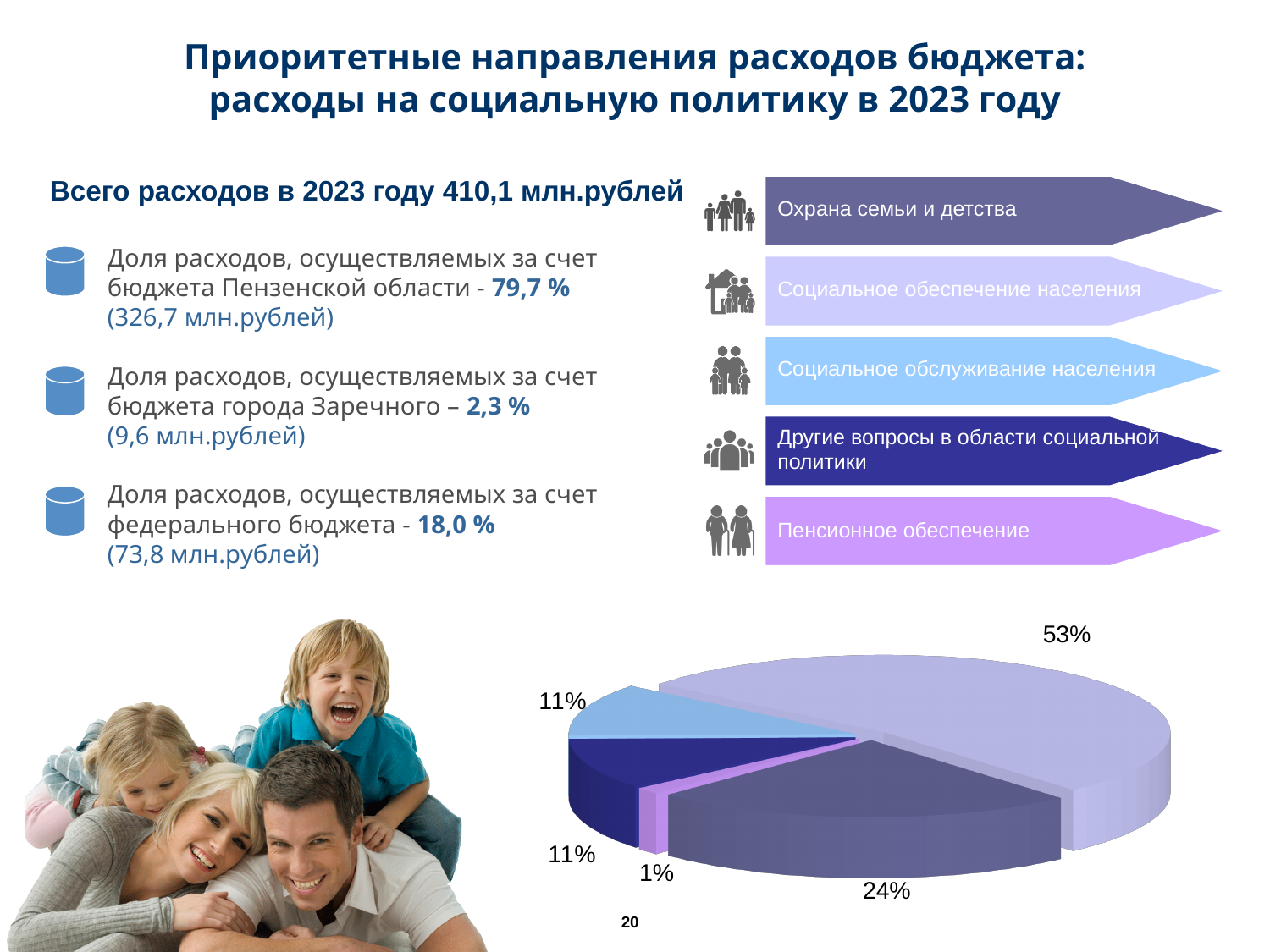
Which is larger on the pie chart: the slice for Охрана семьи и детства (24%) or the slice for Социальное обслуживание населения (11%)? Охрана семьи и детства What is the smallest percentage shown on the pie chart? 1% What share of the pie chart does the violet slice for Пенсионное обеспечение have? 1% Which category does the largest slice (53%) of the pie chart correspond to, based on the colour-coded list on the right? Социальное обеспечение населения What share of the pie chart does the slate-blue slice for Охрана семьи и детства have? 24% How many categories are listed in the colour-coded arrow list on the right of the slide? 5 What is the combined share of the two slices labelled 11% on the pie chart? 22% What is the difference in percentage points between the 53% slice and the 24% slice of the pie chart? 29 How many slices does the pie chart have? 5 What kind of chart is shown at the bottom right of the slide? pie chart How many slices of the pie chart are labelled 11%? 2 What is the largest percentage shown on the pie chart? 53%